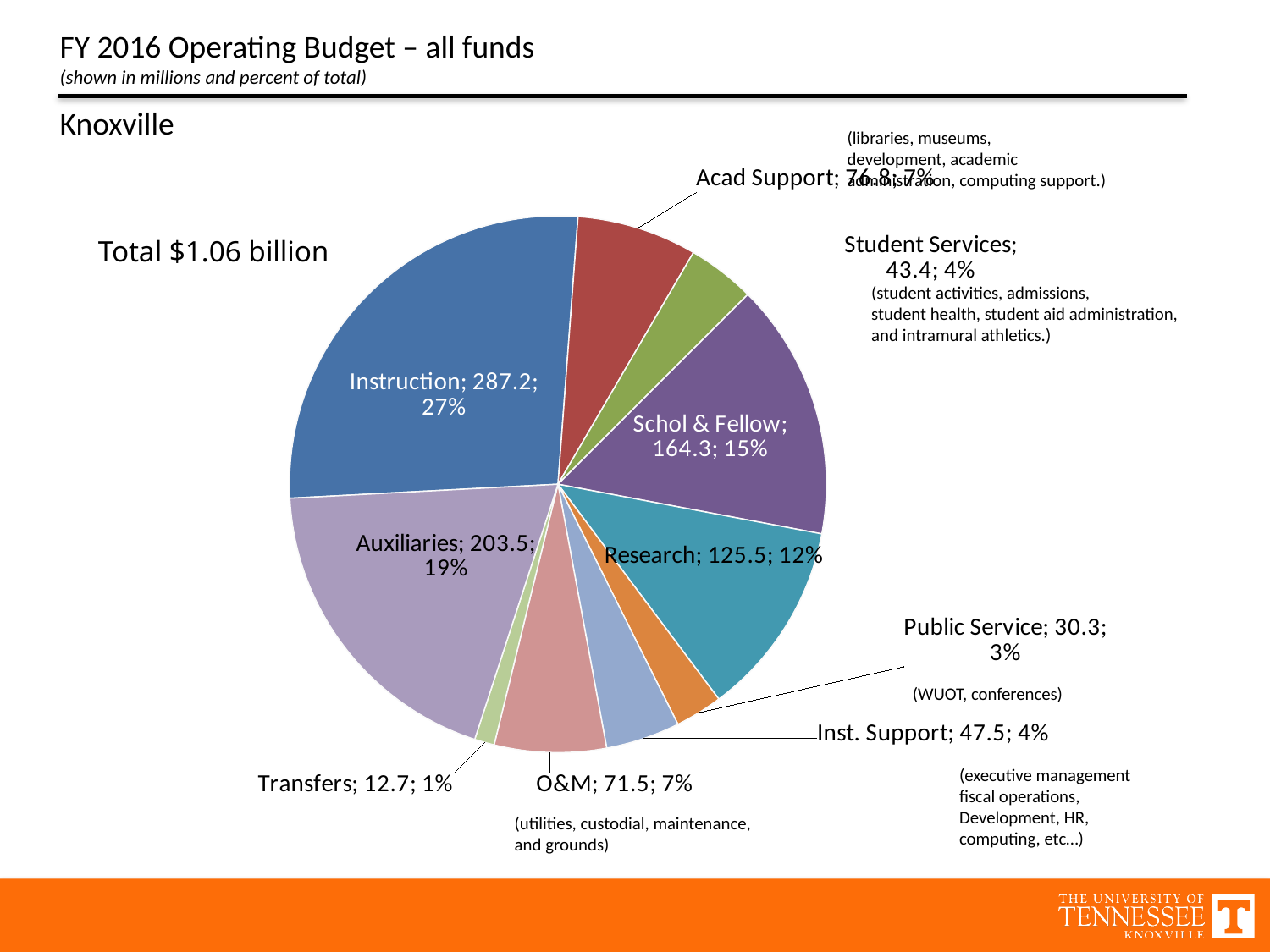
What is the difference in millions between Instruction (287.2) and Auxiliaries (203.5)? 83.7 What is the value (in millions) for O&M? 71.5 Which category has the largest slice of the pie chart? Instruction What is the value (in millions) for Instruction in the pie chart? 287.2 Which category has the smallest slice of the pie chart? Transfers What kind of chart is shown on the slide? pie chart Which is larger in the pie chart, Research or Schol & Fellow? Schol & Fellow What total budget amount is stated next to the pie chart? $1.06 billion How many slices does the pie chart have? 10 What is the value (in millions) for Public Service? 30.3 What percent of the total does Research represent in the pie chart? 12% What percent of the total does Auxiliaries represent? 19%